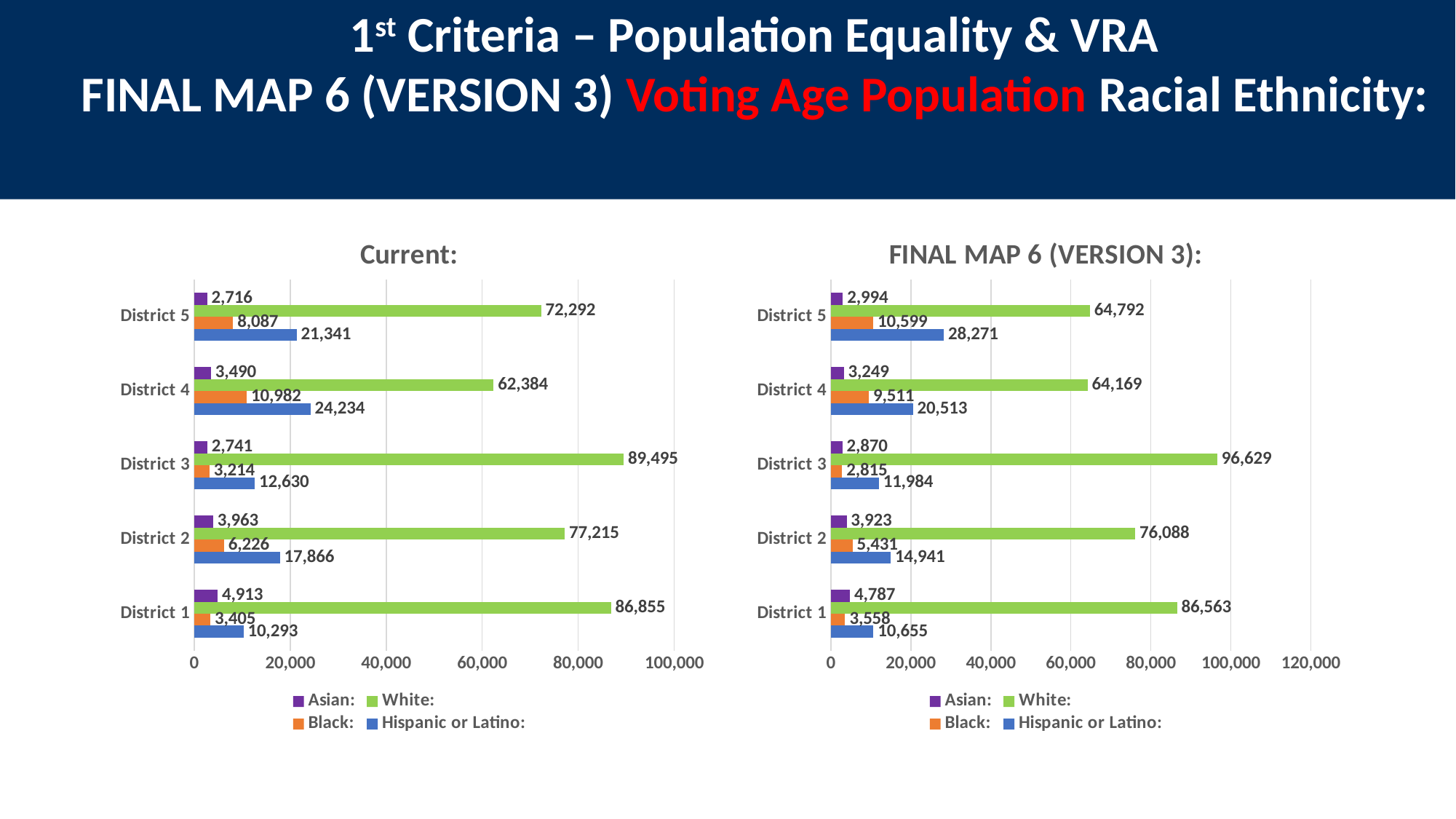
In the 'Current:' chart, which district has the lowest Black value? District 3 In the 'FINAL MAP 6 (VERSION 3):' chart, which is larger: the Black value for District 5 or the Black value for District 4? District 5 In the 'FINAL MAP 6 (VERSION 3):' chart, what is the Asian value for District 1? 4,787 In the 'Current:' chart, what is the difference between the Hispanic or Latino values for District 4 and District 1? 13,941 What type of chart is the 'Current:' chart? bar chart In the 'Current:' chart, is the White value for District 5 greater or less than 80,000? less Which colour represents the White series in the 'Current:' chart? green In the 'Current:' chart, what is the White voting age population for District 3? 89,495 In the 'FINAL MAP 6 (VERSION 3):' chart, what is the Hispanic or Latino value for District 5? 28,271 How many series does the legend of the 'FINAL MAP 6 (VERSION 3):' chart list? 4 In the 'FINAL MAP 6 (VERSION 3):' chart, which district has the highest White value? District 3 How many districts are shown in the 'Current:' chart? 5